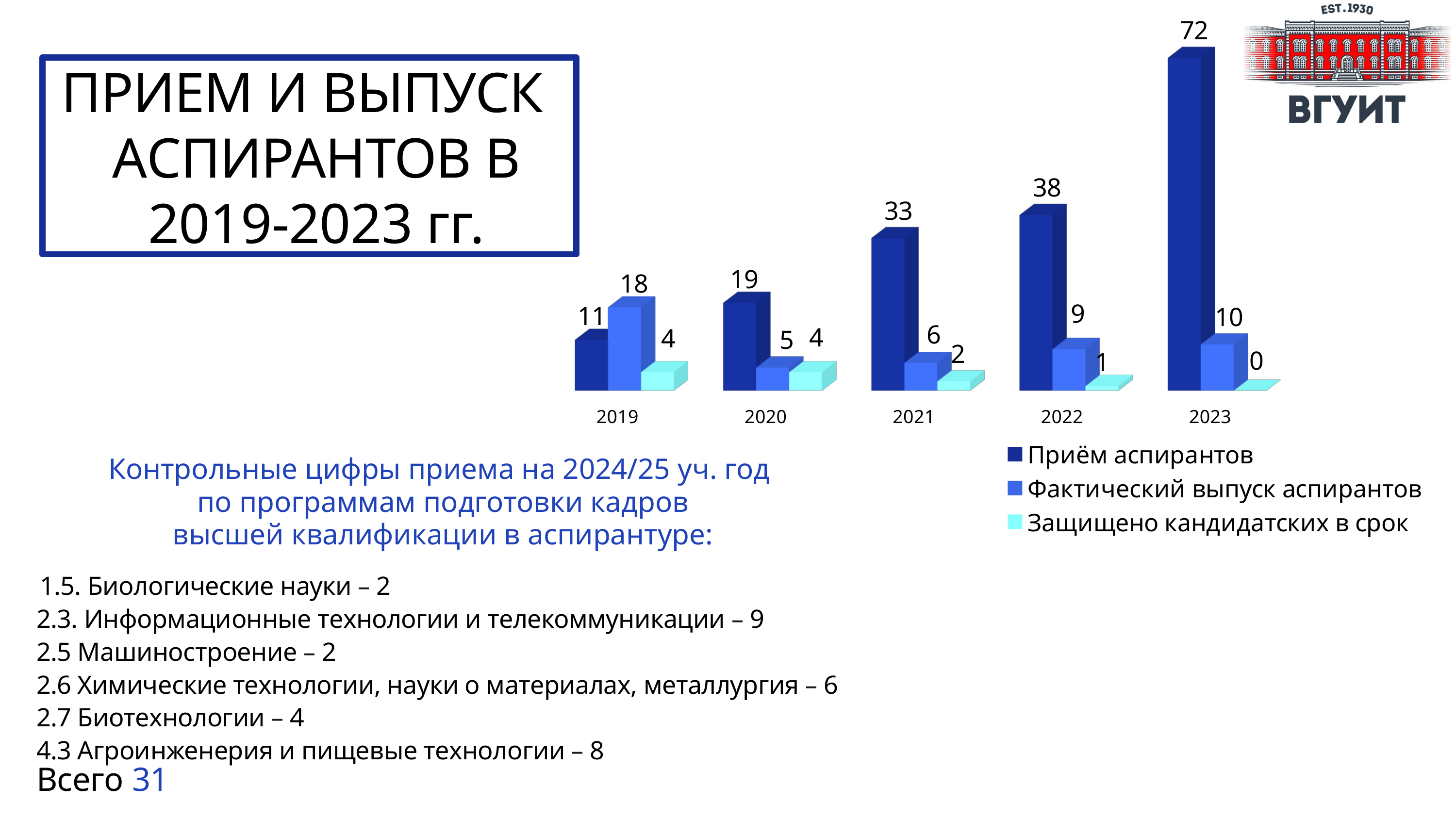
What was the value of Приём аспирантов in 2023? 72 In which year was Защищено кандидатских в срок the lowest? 2023 What is the difference between Приём аспирантов in 2023 and in 2022? 34 What was the value of Защищено кандидатских в срок in 2021? 2 How many series does the chart legend list? 3 Which was larger in 2019: Приём аспирантов or Фактический выпуск аспирантов? Фактический выпуск аспирантов What kind of chart is shown on the slide? bar chart What was the value of Фактический выпуск аспирантов in 2019? 18 Does Приём аспирантов rise or fall from 2019 to 2023? rise How many years are shown on the x axis of the chart? 5 In which year was Приём аспирантов the highest? 2023 What is the difference between Фактический выпуск аспирантов in 2019 and in 2020? 13